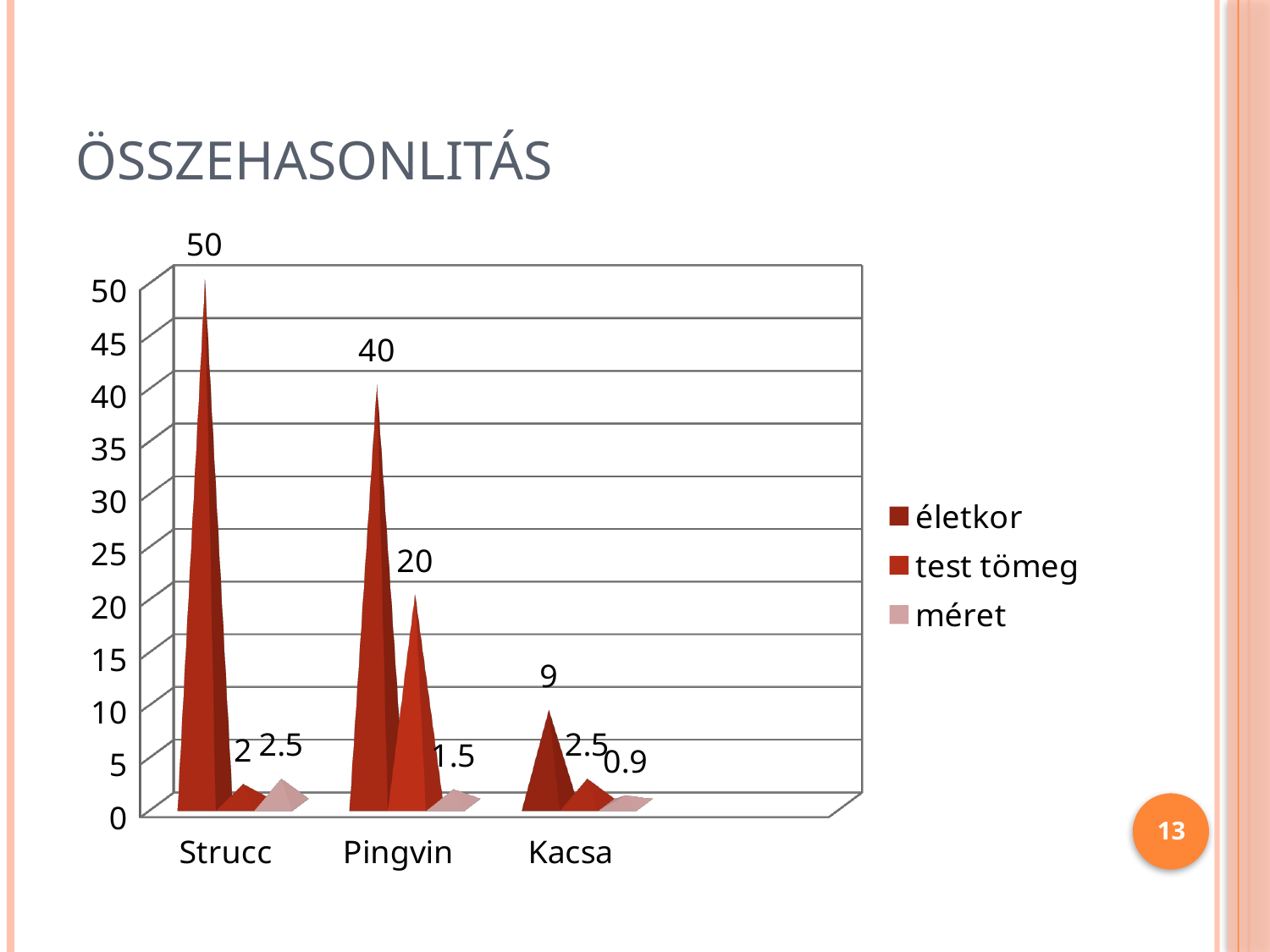
What is the életkor value for Strucc? 50 What is the test tömeg value for Pingvin? 20 Which category has the highest életkor value? Strucc What is the méret value for Kacsa? 0.9 How many series does the legend list? 3 What is the title of the slide containing the chart? ÖSSZEHASONLITÁS How many categories are shown on the x axis? 3 Is the életkor value for Pingvin greater or less than 35? greater Which is larger, the test tömeg value for Pingvin or the test tömeg value for Kacsa? Pingvin What is the méret value for Strucc? 2.5 What is the difference between the életkor values for Strucc and Pingvin? 10 Which category has the lowest életkor value? Kacsa